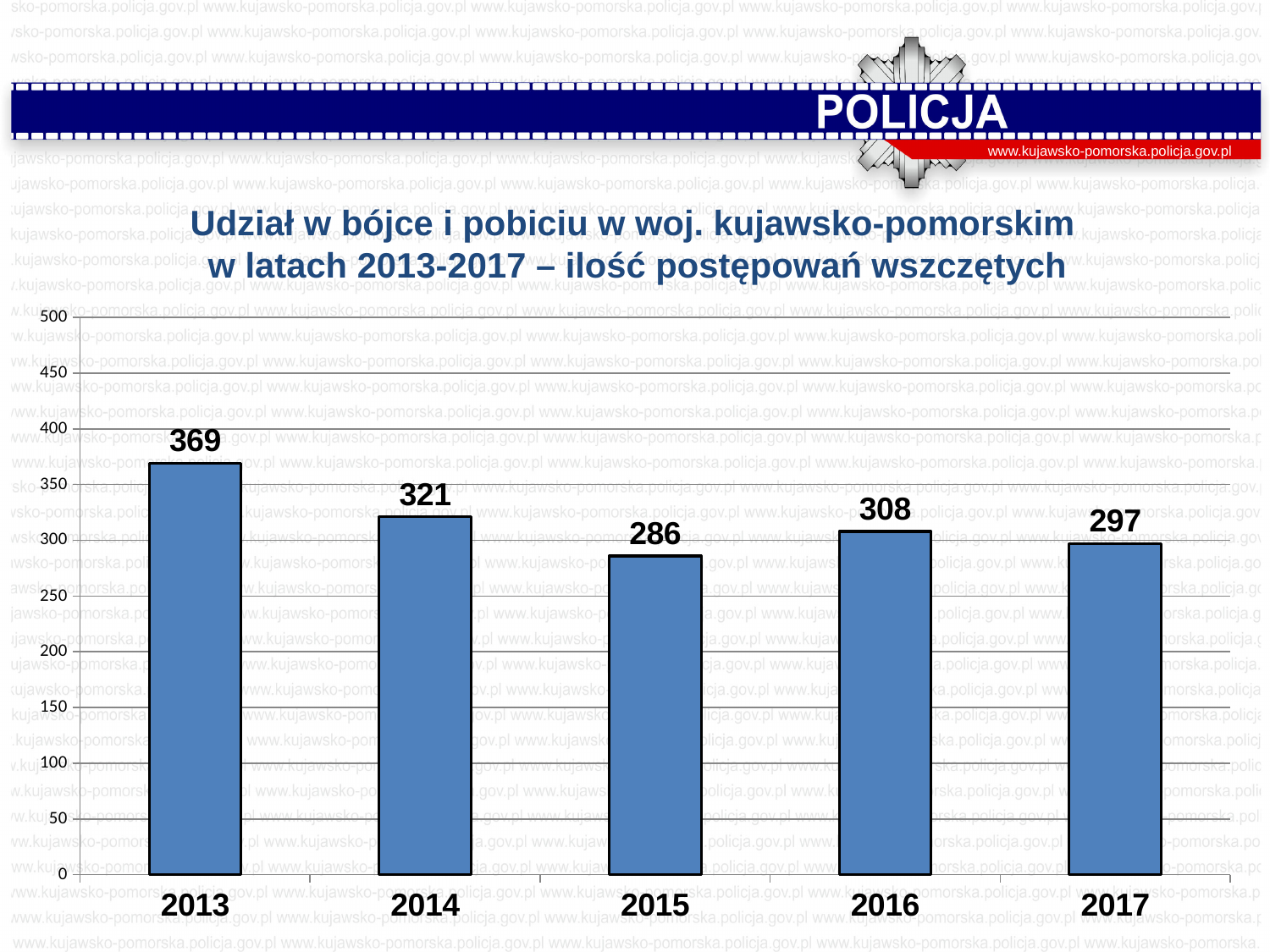
What is the difference between the values for 2016 and 2017? 11 What is the value for 2017? 297 What is the value for 2015? 286 Do the values rise or fall from 2013 to 2015? fall Which is larger, the value for 2014 or the value for 2016? 2014 Is the value for 2015 greater or less than 300? less Which year has the highest value? 2013 What is the value for 2013? 369 What kind of chart is shown on the slide? bar chart How many years are shown on the x axis? 5 Which year has the lowest value? 2015 What is the difference between the values for 2013 and 2014? 48